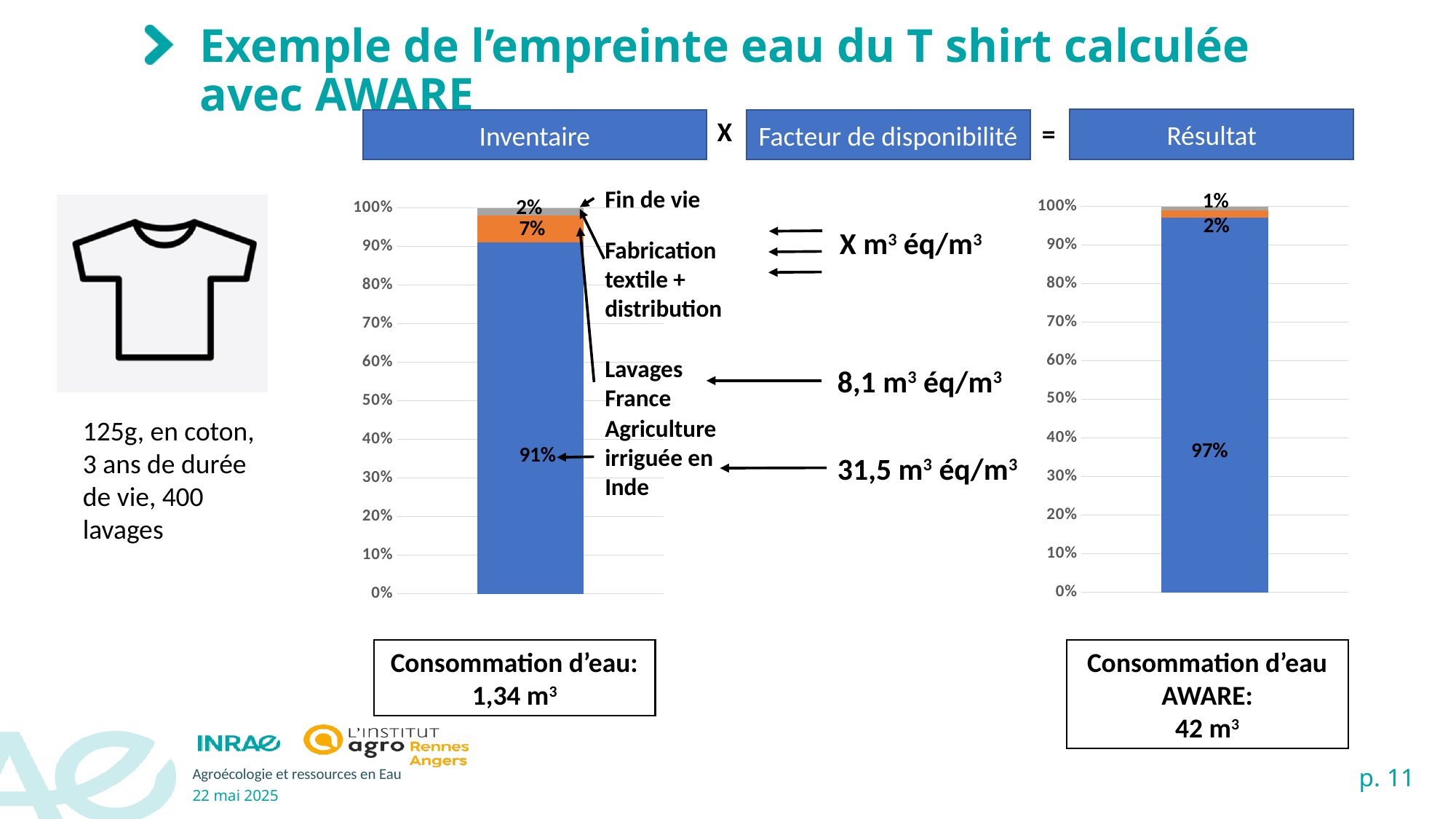
In the Inventaire chart, what percentage is shown for the largest blue segment (Agriculture irriguée en Inde)? 91% In the Résultat chart, what percentage is shown for the orange segment? 2% What kind of chart is used for the Inventaire and Résultat panels? Stacked bar chart Which is larger: the blue segment in the Inventaire chart or the blue segment in the Résultat chart? Résultat (97%) In the Inventaire chart, is the blue segment greater or less than 90%? greater In the Inventaire chart, what percentage is shown for the grey segment (Fin de vie)? 2% What is the total water consumption shown below the Inventaire chart? 1,34 m³ In the Résultat chart, what percentage is shown for the grey segment at the top? 1% In the Inventaire chart, what is the difference between the blue segment (91%) and the orange segment (7%)? 84% In the Résultat chart, what percentage is shown for the blue segment? 97% In the Inventaire chart, what percentage is shown for the orange segment (Fabrication textile + distribution)? 7% In the Inventaire chart, which segment has the smallest share? Fin de vie (2%)